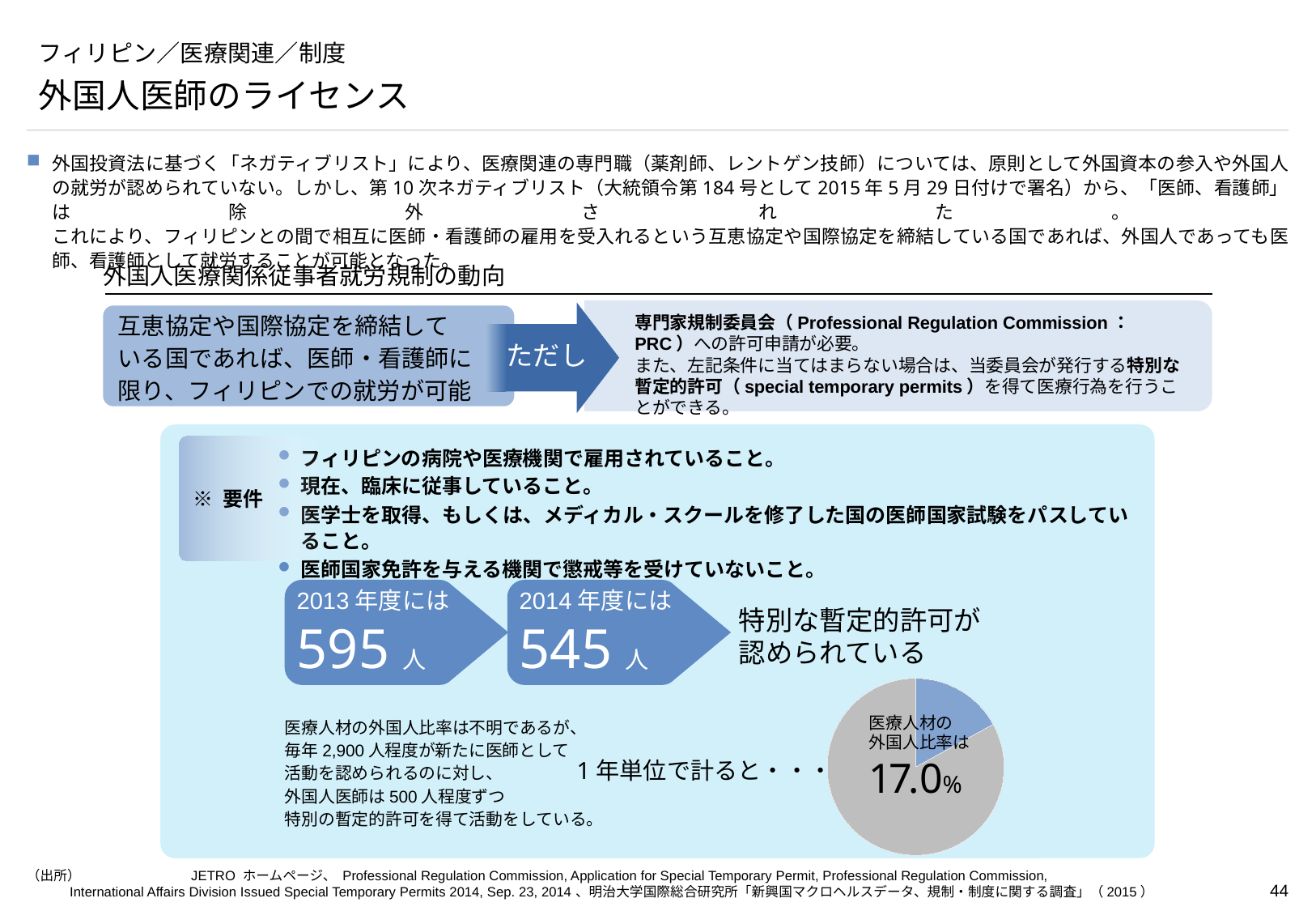
Is the blue slice in the pie chart greater or less than 50% of the pie? less What share of the pie does the blue slice represent? 17.0% What colour is the slice in the pie chart that represents the 17.0% foreign ratio? blue In the pie chart, what value is shown for 医療人材の外国人比率 (the foreign ratio of medical personnel)? 17.0% In the pie chart, which slice is larger: the blue slice or the gray slice? the gray slice How many slices does the pie chart have? 2 What kind of chart is shown at the bottom right of the slide? pie chart